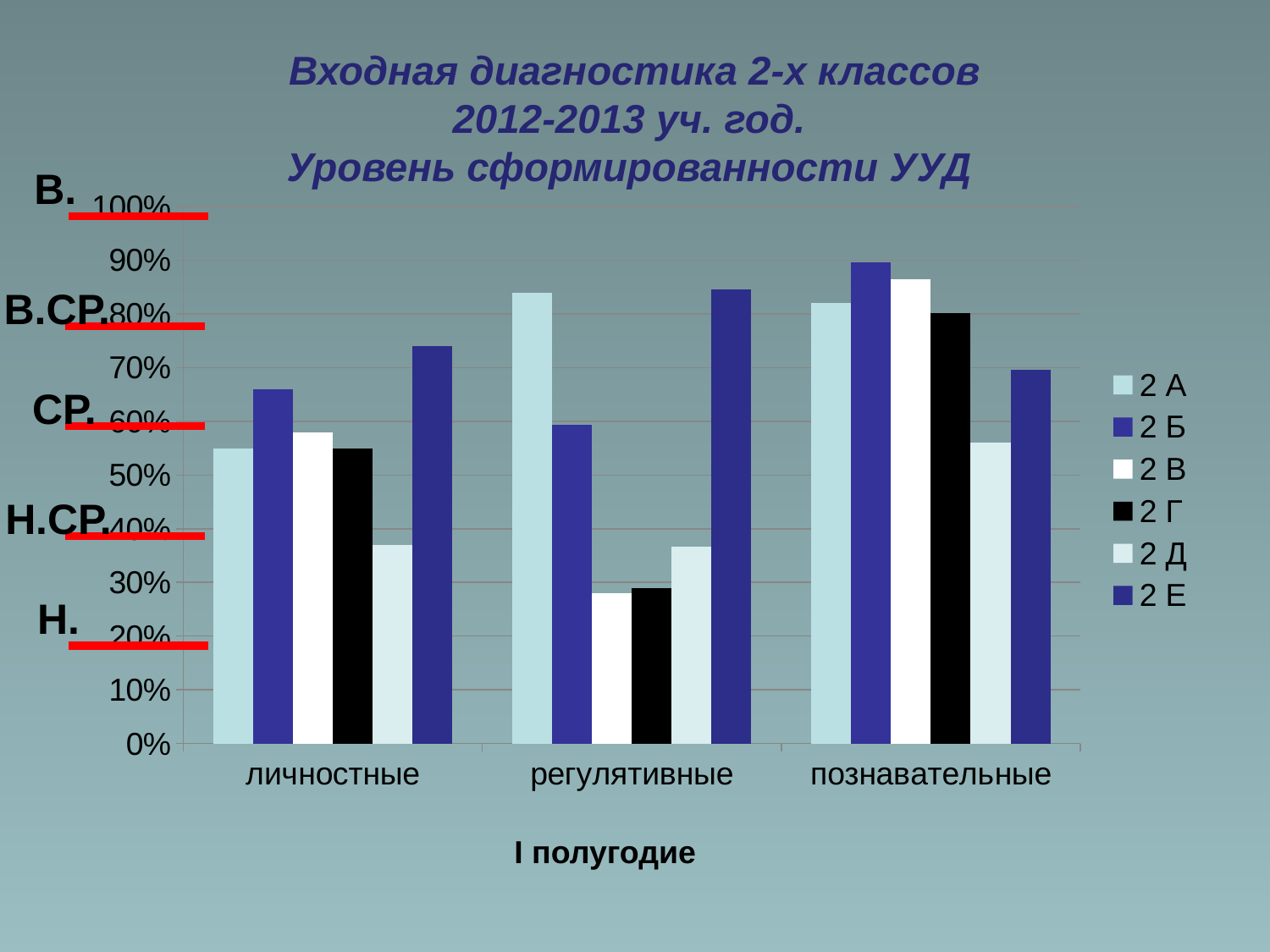
How many series does the chart's legend list? 6 Which series has the highest value in the личностные category? 2 Е What label is printed below the x axis of the chart? I полугодие Which series has the lowest value in the познавательные category? 2 Д Is the value for 2 Д in the регулятивные category greater or less than 40%? less Is the value for 2 Б in the познавательные category greater or less than 80%? greater What kind of chart is shown on the slide? bar chart How many categories are shown on the x axis of the chart? 3 What colour are the bars for the 2 Г series? black Is the value for 2 Е in the личностные category greater or less than 70%? greater In the регулятивные category, which is larger: the value for 2 А or the value for 2 Б? 2 А